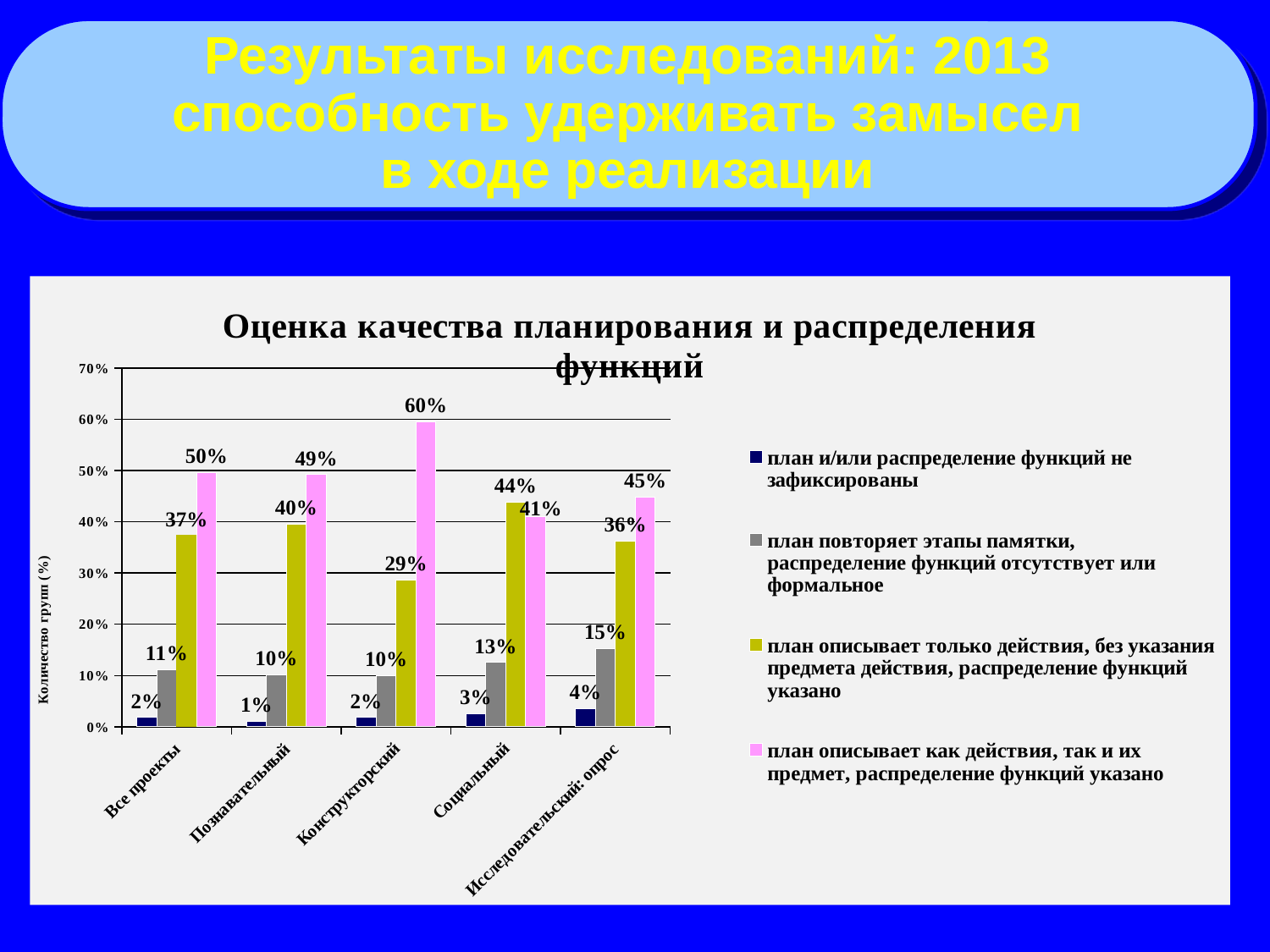
Which category has the lowest value for the dark blue series (план и/или распределение функций не зафиксированы)? Познавательный For Социальный, which is larger: the olive series (план описывает только действия) or the pink series (план описывает как действия, так и их предмет)? olive series (44%) How many series does the legend list? 4 What is the value of the grey series (план повторяет этапы памятки) for Исследовательский: опрос? 15% Which category has the highest value for the pink series (план описывает как действия, так и их предмет)? Конструкторский What is the difference between the pink series value for Конструкторский and for Социальный? 19% What is the label of the vertical axis of the chart? Количество групп (%) How many categories are shown on the x axis of the chart? 5 What is the value of the pink series (план описывает как действия, так и их предмет, распределение функций указано) for Конструкторский? 60% What type of chart is shown on the slide? bar chart What is the value of the olive series (план описывает только действия) for Социальный? 44% What is the title of the chart? Оценка качества планирования и распределения функций